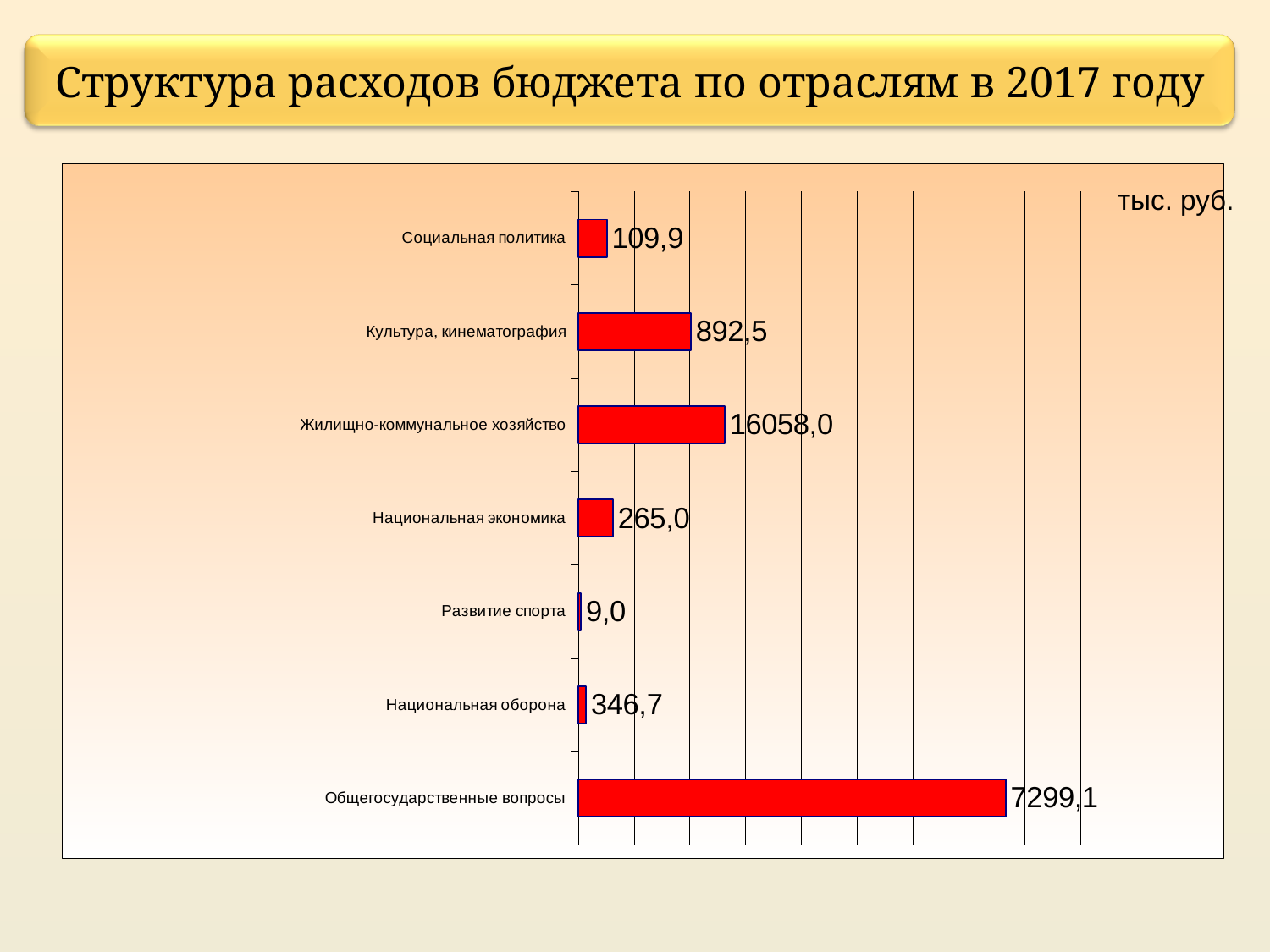
What is the value for Национальная экономика? 265,0 What is the value for Развитие спорта? 9,0 What is the value for Культура, кинематография? 892,5 What kind of chart is shown on the slide? Bar chart What is the value for Социальная политика? 109,9 What is the value for Жилищно-коммунальное хозяйство? 16058,0 What is the value for Национальная оборона? 346,7 Which category has the lowest value? Развитие спорта Which is larger, the value for Национальная экономика or the value for Социальная политика? Национальная экономика How many categories are shown in the chart? 7 What is the value for Общегосударственные вопросы? 7299,1 What is the difference between the values for Национальная экономика and Социальная политика? 155,1